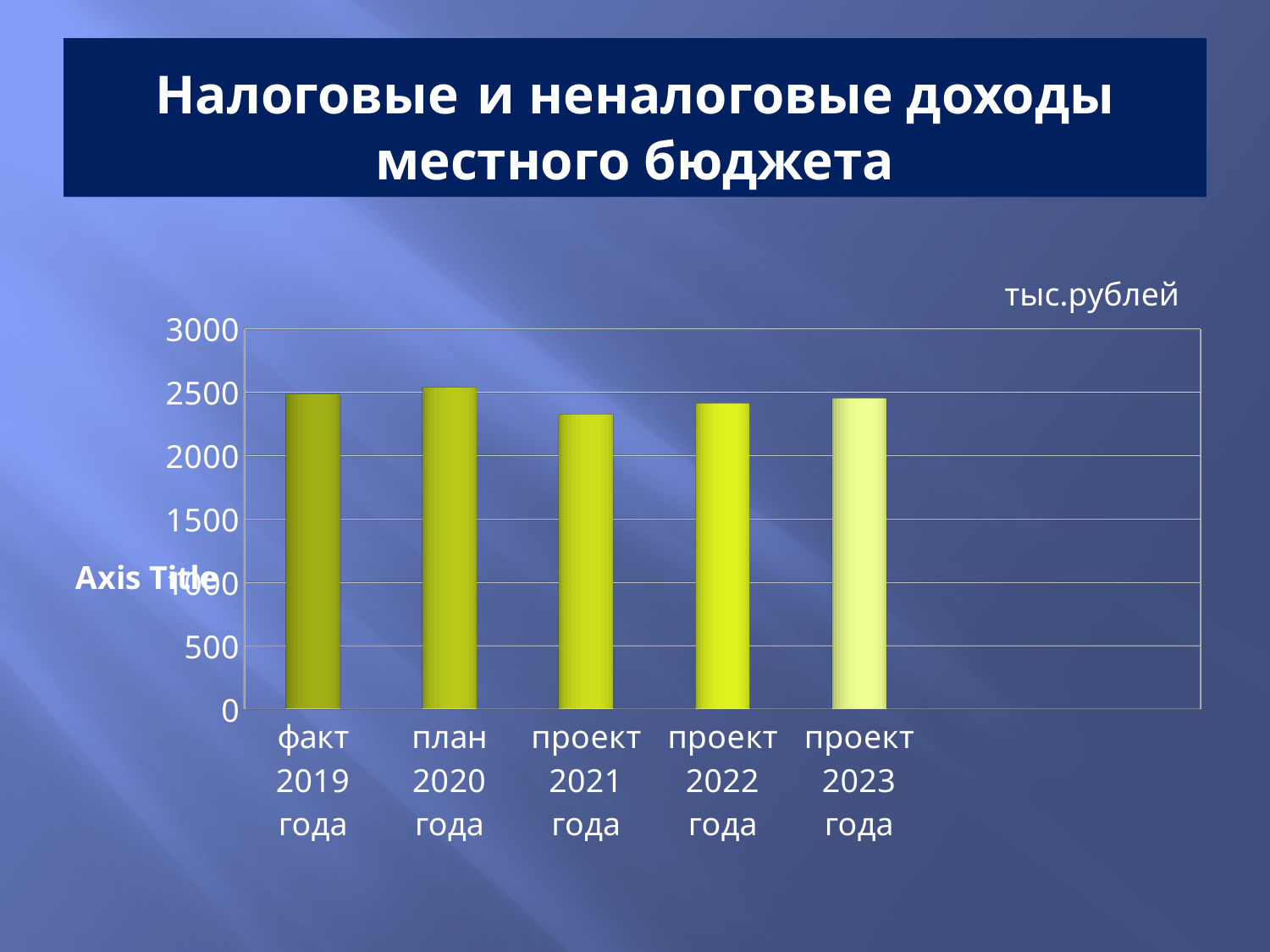
Is the value for проект 2023 года greater or less than 3000? less How many bars (categories) are plotted in the chart? 5 Which is larger, the value for проект 2021 года or the value for проект 2023 года? проект 2023 года Is the value for факт 2019 года greater or less than 2000? greater What kind of chart is shown on the slide? bar chart What unit of measurement is indicated above the chart? тыс.рублей Which is larger, the value for план 2020 года or the value for проект 2021 года? план 2020 года Is the value for план 2020 года greater or less than 2500? greater Which category has the lowest bar? проект 2021 года What is the title of the slide? Налоговые и неналоговые доходы местного бюджета Which category has the highest bar? план 2020 года